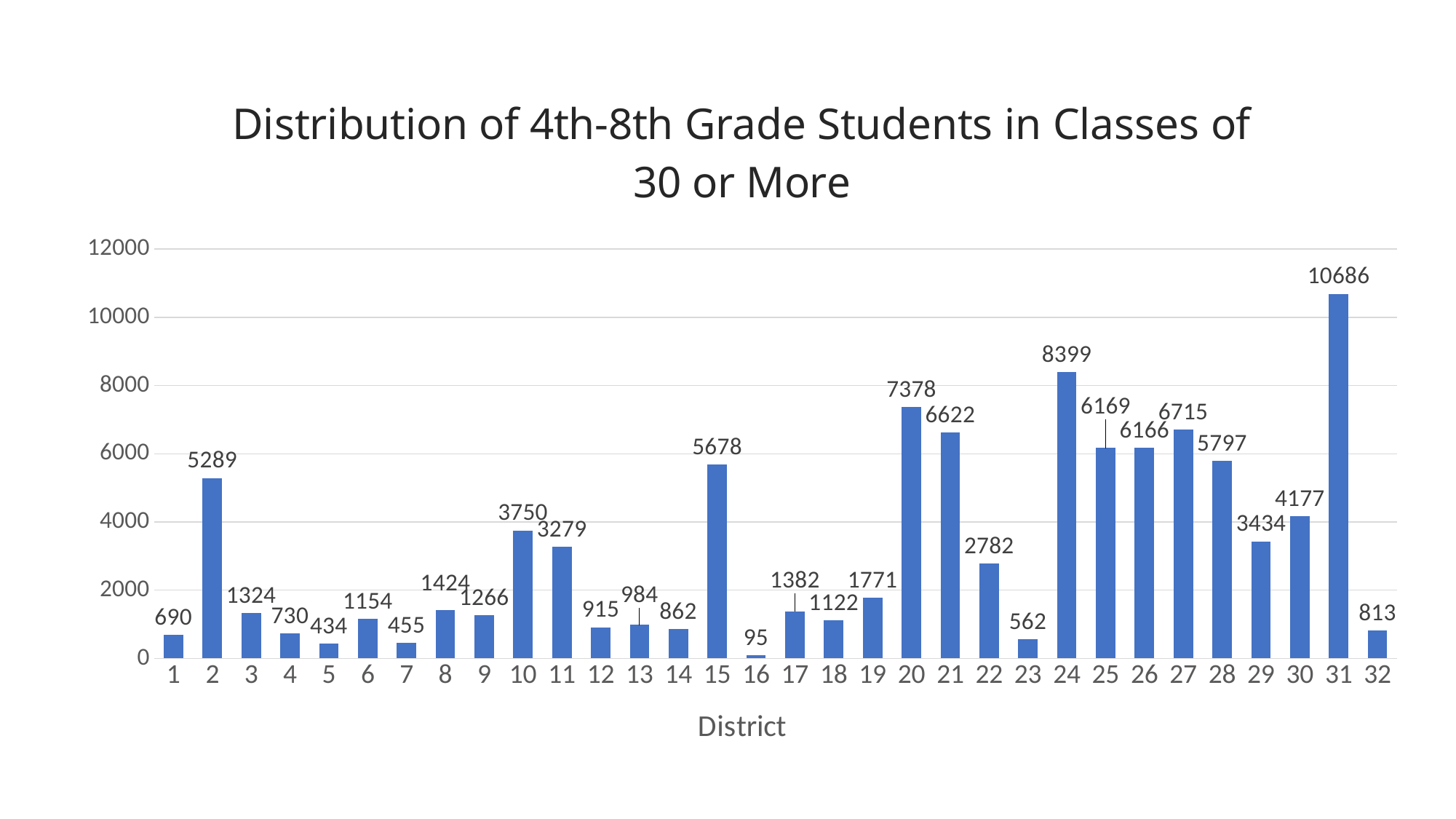
Which is larger, the value for District 15 or the value for District 21? District 21 What is the difference between the values for District 24 and District 2? 3110 What is the title of the chart? Distribution of 4th-8th Grade Students in Classes of 30 or More What is the value for District 16? 95 Is the value for District 28 greater or less than 4000? greater What is the label of the x axis? District What is the value for District 31? 10686 What is the value for District 20? 7378 Which district has the lowest value? 16 How many districts are shown on the x axis? 32 What kind of chart is this? bar chart Which district has the highest value? 31